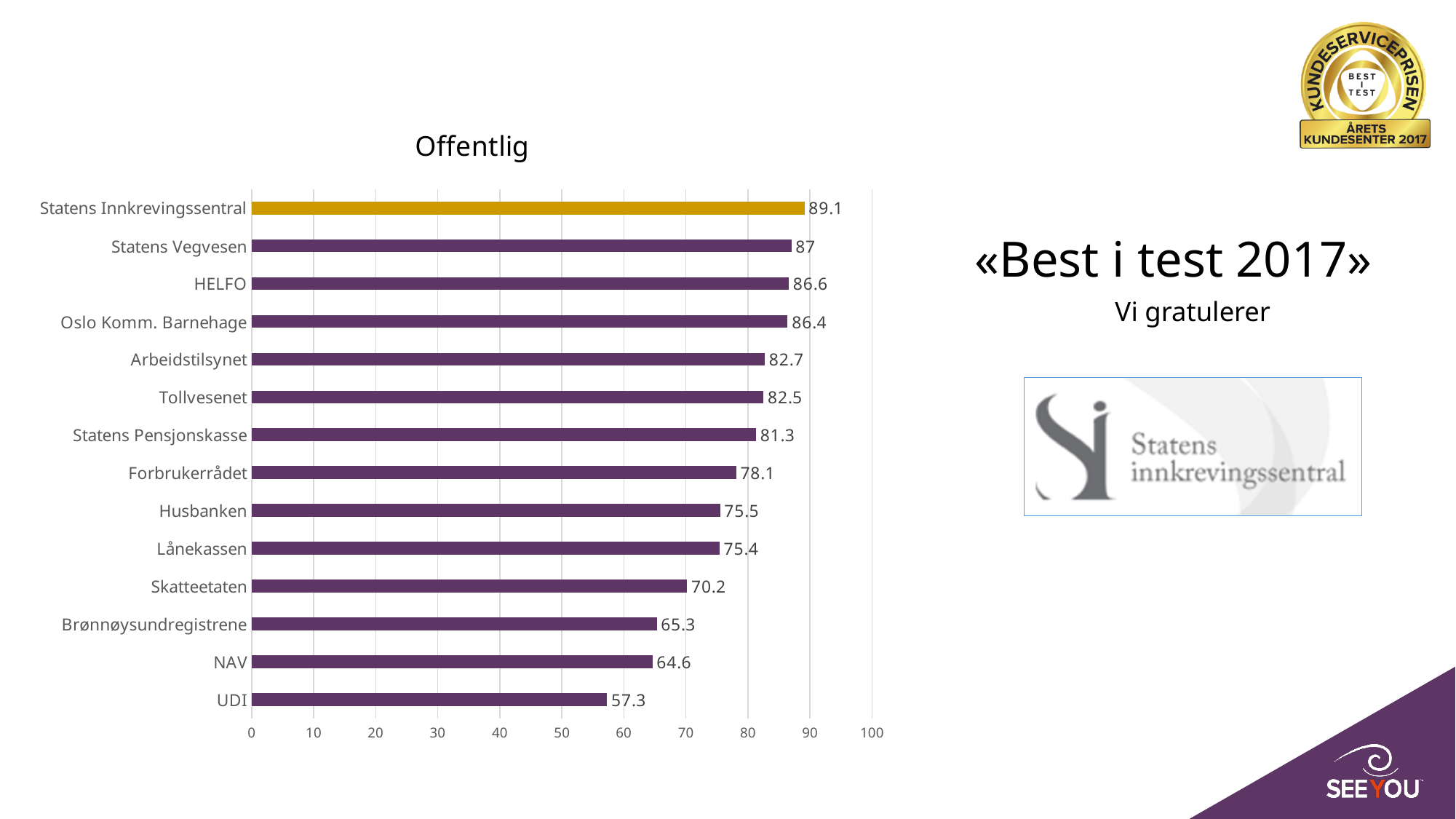
What is the difference between the values for Statens Innkrevingssentral and UDI? 31.8 Which category has the highest value? Statens Innkrevingssentral What is the value for NAV? 64.6 What kind of chart is shown on the slide? bar chart What is the value for Skatteetaten? 70.2 What is the title of the chart? Offentlig Which category has the lowest value? UDI Is the value for Brønnøysundregistrene greater or less than 70? less What is the difference between the values for Statens Vegvesen and HELFO? 0.4 Which has a larger value, Forbrukerrådet or Husbanken? Forbrukerrådet How many categories are shown in the chart? 14 What is the value for Statens Innkrevingssentral? 89.1